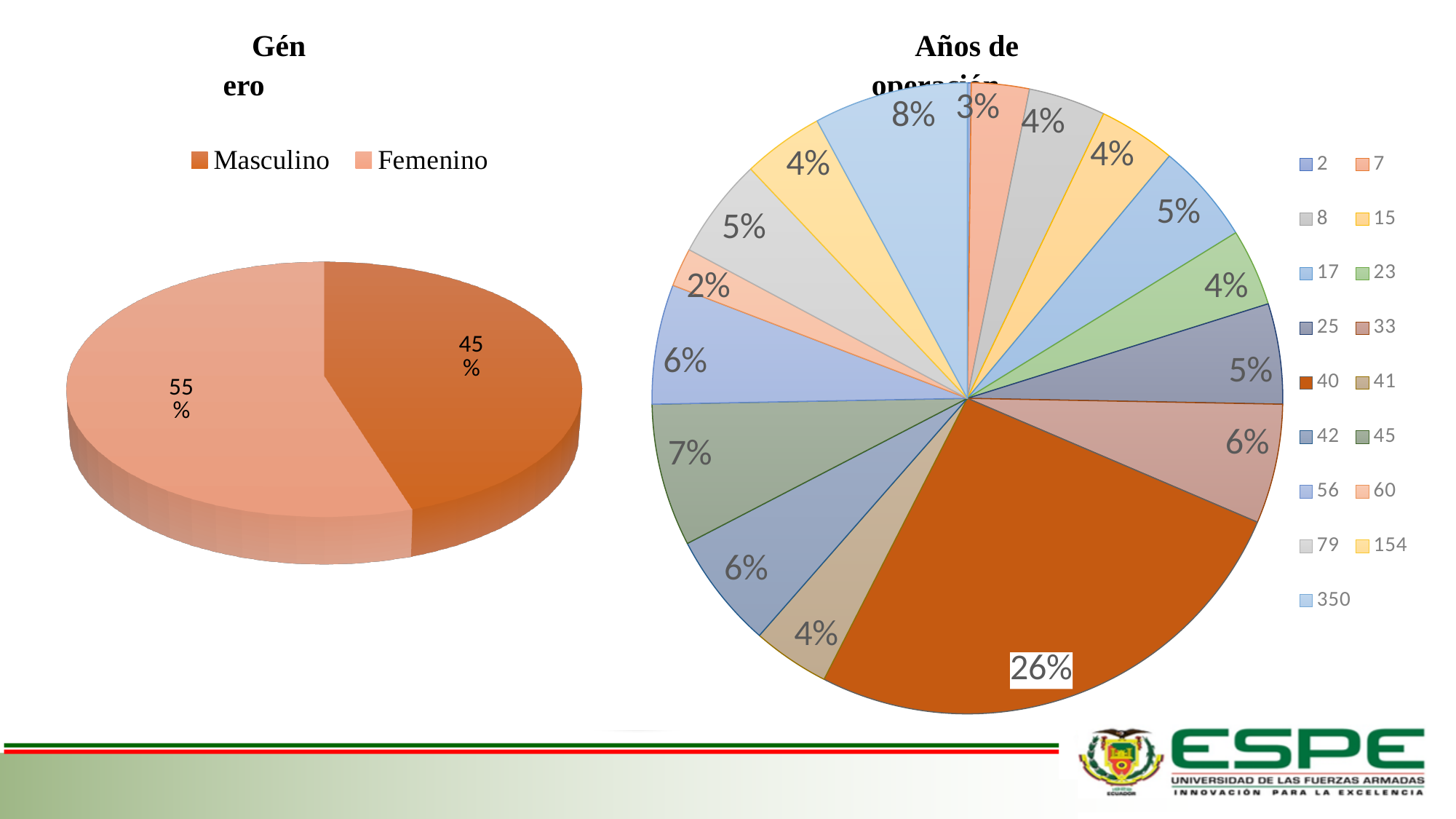
What kind of chart is the Años de operación chart? Pie chart On the Género chart, how many series does the legend list? 2 On the Años de operación chart, what is the share of the largest slice? 26% On the Género chart, what is the difference between the Femenino and Masculino shares? 10% On the Género chart, what percentage is Femenino? 55% On the Años de operación chart, which legend category corresponds to the largest slice (26%)? 40 On the Años de operación chart, what is the smallest labelled share? 2% On the Género chart, which category has the larger share? Femenino On the Género chart, what percentage is Masculino? 45% On the Años de operación chart, what is the largest value listed in the legend? 350 On the Años de operación chart, how many categories does the legend list? 17 What kind of chart is the Género chart? Pie chart